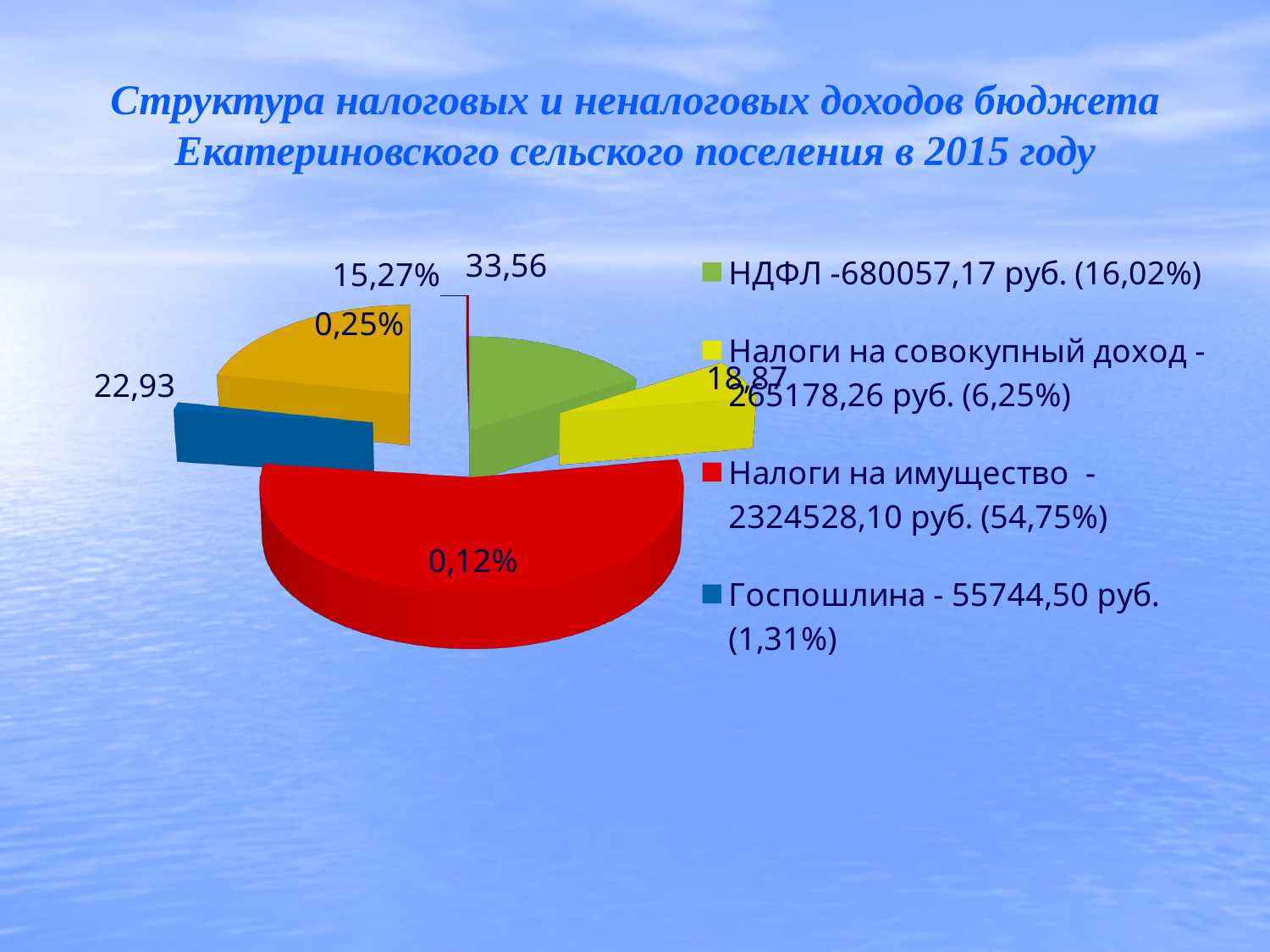
Which has a larger percentage share according to the legend, НДФЛ or Налоги на совокупный доход? НДФЛ According to the legend, what amount in rubles is given for НДФЛ? 680057,17 руб. What is the difference between the legend percentages for Налоги на имущество and НДФЛ? 38,73% How many entries does the legend of the pie chart list? 4 What is the title of the chart on the slide? Структура налоговых и неналоговых доходов бюджета Екатериновского сельского поселения в 2015 году Which legend category has the largest percentage share? Налоги на имущество Which legend category has the smallest percentage share? Госпошлина According to the legend, what percentage share is given for Налоги на совокупный доход? 6,25% What colour represents Налоги на имущество in the pie chart? red According to the legend, what percentage share is given for Налоги на имущество? 54,75% What kind of chart is shown on the slide? pie chart According to the legend, what amount in rubles is given for Госпошлина? 55744,50 руб.